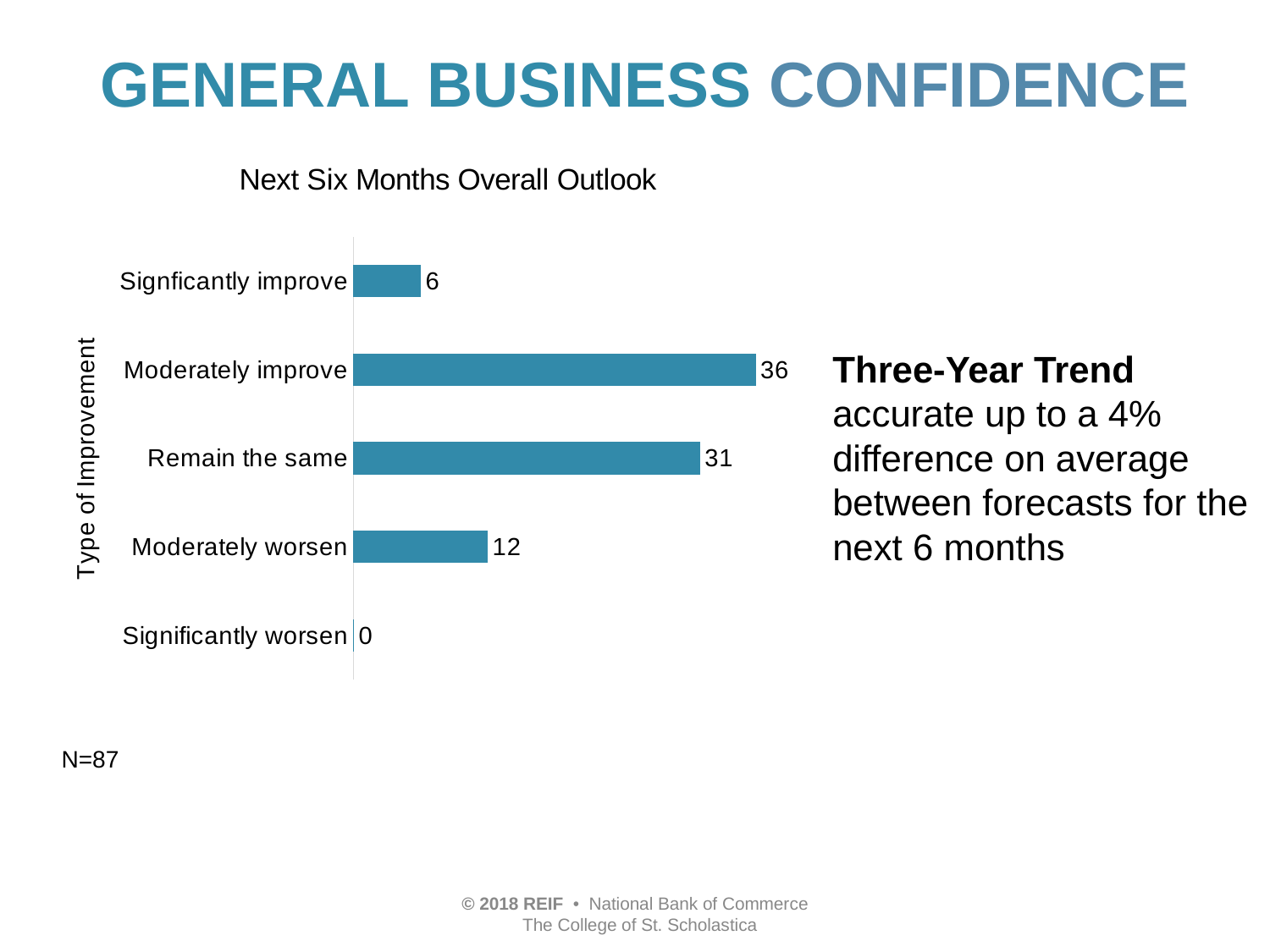
What is the value for Remain the same? 31 Which is larger, the value for Moderately worsen or the value for Signficantly improve? Moderately worsen How many categories are shown in the chart? 5 What is the difference between the values for Moderately improve and Remain the same? 5 What is the title of the chart? Next Six Months Overall Outlook What is the value for Moderately improve? 36 Which category has the lowest value? Significantly worsen Which category has the highest value? Moderately improve What is the value for Signficantly improve? 6 What is the value for Significantly worsen? 0 What is the value for Moderately worsen? 12 What kind of chart is shown on the slide? Bar chart